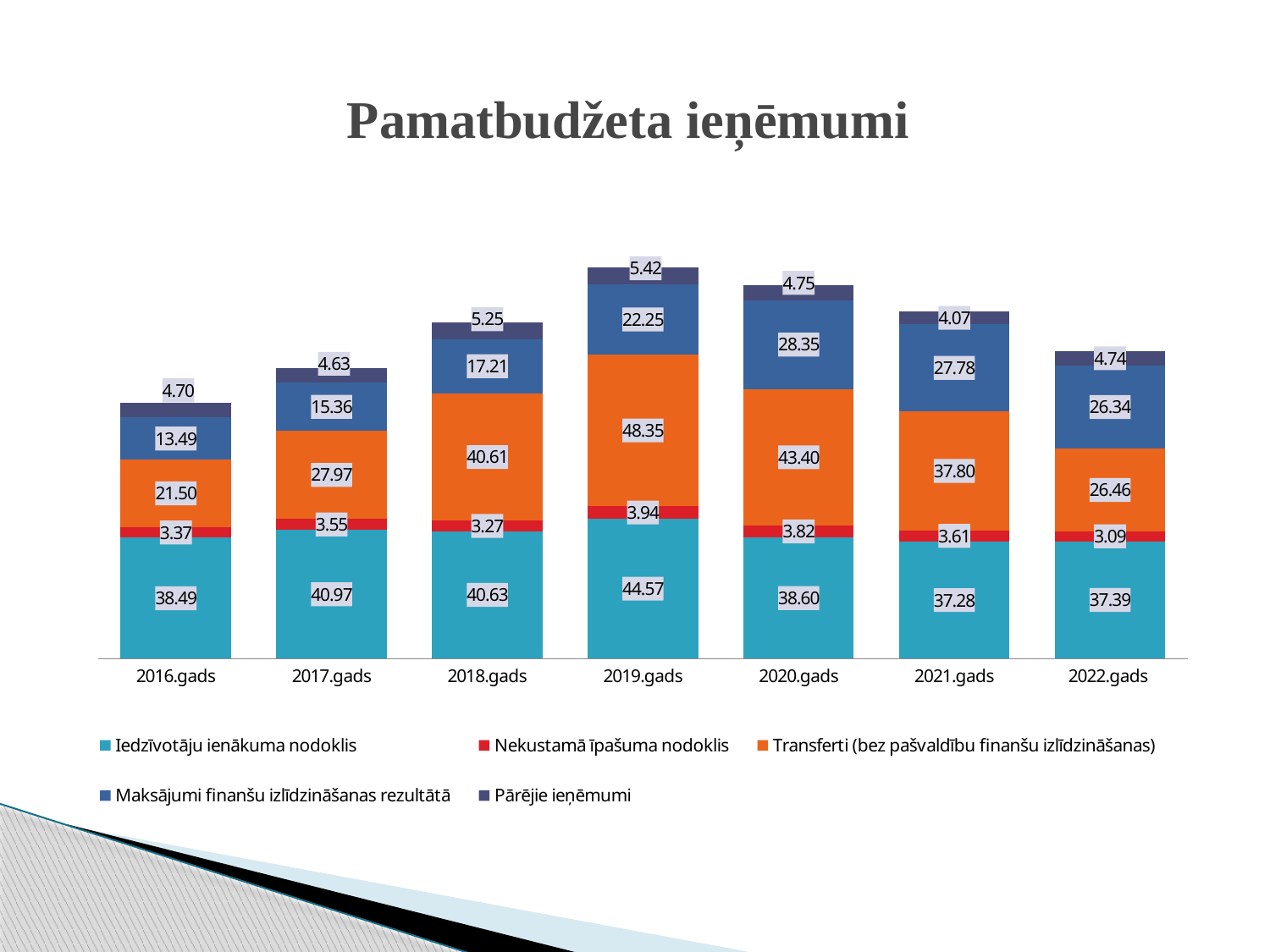
What is the value of Iedzīvotāju ienākuma nodoklis for 2019.gads? 44.57 What is the difference between the Maksājumi finanšu izlīdzināšanas rezultātā values for 2019.gads and 2016.gads? 8.76 What is the value of Transferti (bez pašvaldību finanšu izlīdzināšanas) for 2021.gads? 37.80 How many years (categories) are shown on the x axis? 7 What type of chart is shown on the slide? stacked bar chart What is the value of Maksājumi finanšu izlīdzināšanas rezultātā for 2020.gads? 28.35 What is the title of the chart? Pamatbudžeta ieņēmumi In which year is the Nekustamā īpašuma nodoklis value the lowest? 2022.gads How many series does the legend list? 5 Which is larger: Iedzīvotāju ienākuma nodoklis in 2017.gads or in 2020.gads? 2017.gads In which year is the Transferti (bez pašvaldību finanšu izlīdzināšanas) value the highest? 2019.gads What is the total of the stacked bar for 2016.gads? 81.55